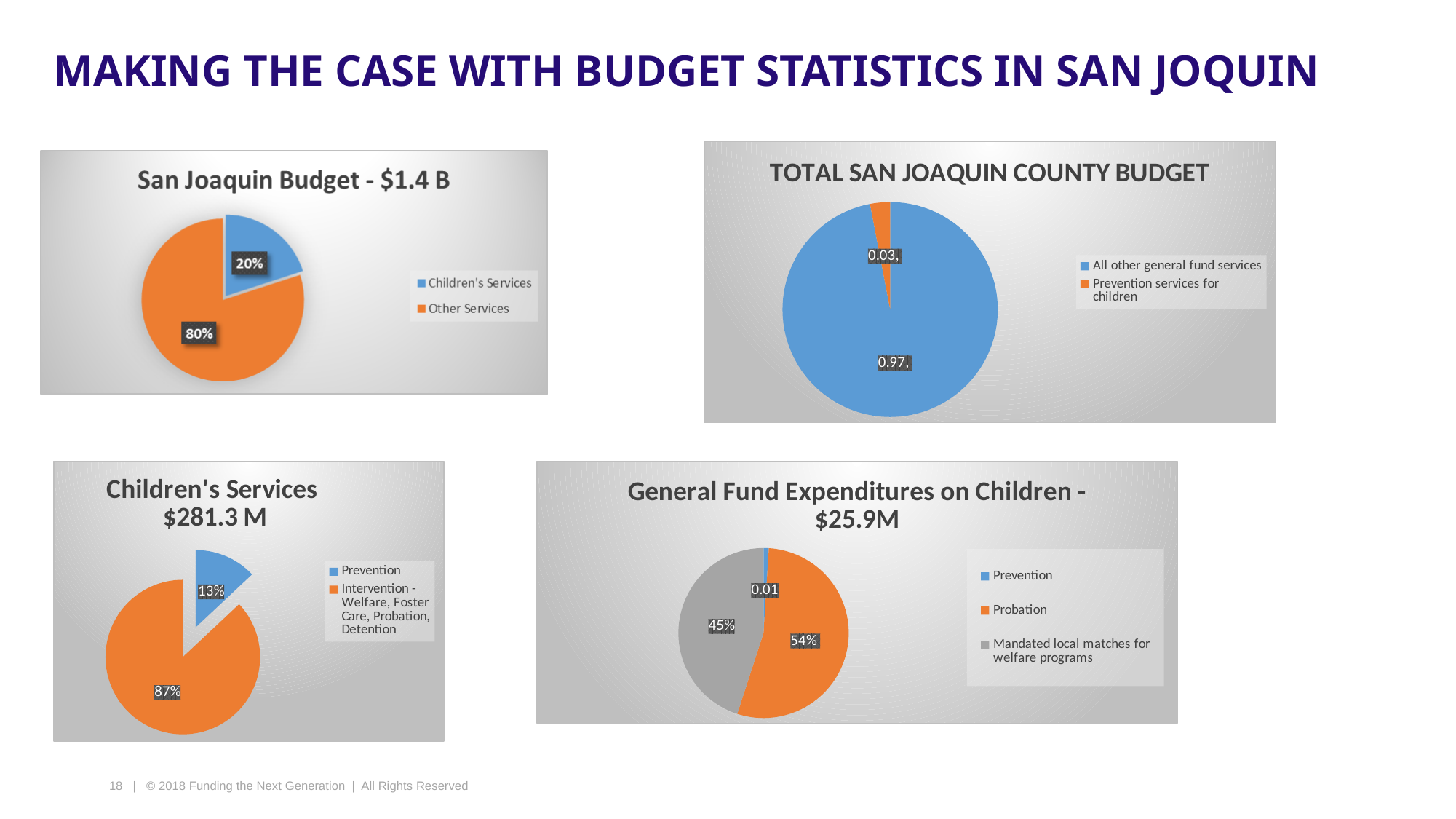
In the 'Children's Services $281.3 M' chart, which category is the smallest? Prevention In the 'San Joaquin Budget - $1.4 B' chart, what share is labelled for Other Services? 80% In the 'TOTAL SAN JOAQUIN COUNTY BUDGET' chart, how many categories does the legend list? 2 In the 'Children's Services $281.3 M' chart, what share is labelled for Prevention? 13% In the 'General Fund Expenditures on Children - $25.9M' chart, which is larger, Probation or Mandated local matches for welfare programs? Probation In the 'General Fund Expenditures on Children - $25.9M' chart, how many categories does the legend list? 3 In the 'TOTAL SAN JOAQUIN COUNTY BUDGET' chart, which category is the largest? All other general fund services In the 'San Joaquin Budget - $1.4 B' chart, what share of the budget goes to Children's Services? 20% In the 'San Joaquin Budget - $1.4 B' chart, what is the difference between the Other Services share and the Children's Services share? 60 percentage points In the 'TOTAL SAN JOAQUIN COUNTY BUDGET' chart, what value is shown for Prevention services for children? 0.03 What type of chart is the 'Children's Services $281.3 M' chart? Pie chart In the 'General Fund Expenditures on Children - $25.9M' chart, what share is labelled for Probation? 54%